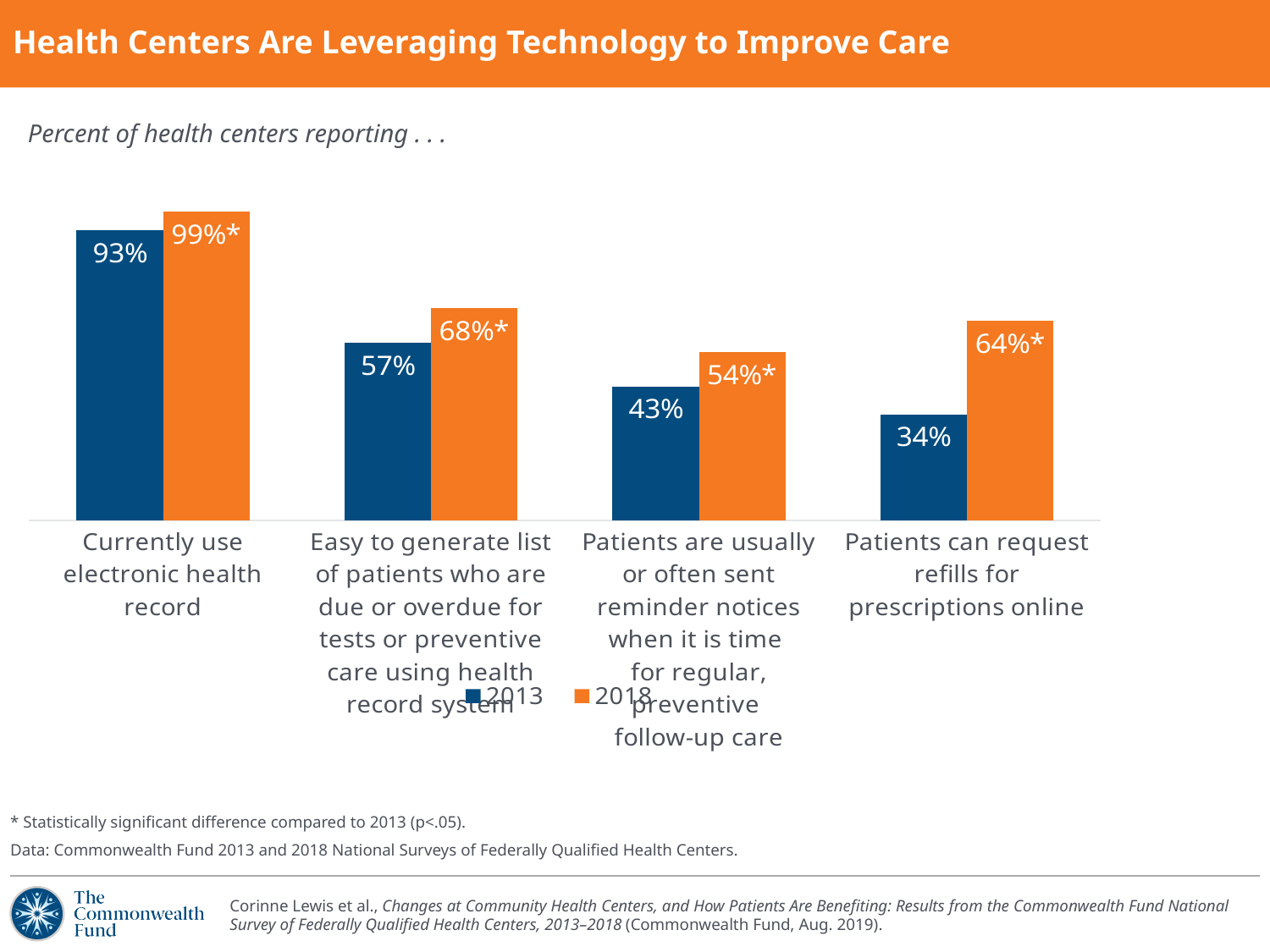
How many series does the chart's legend list? 2 What is the 2013 value for 'Patients are usually or often sent reminder notices when it is time for regular, preventive follow-up care'? 43% By how many percentage points did 'Patients can request refills for prescriptions online' increase from 2013 to 2018? 30 percentage points Which is larger: the 2018 value for 'Patients can request refills for prescriptions online' or the 2018 value for 'Patients are usually or often sent reminder notices'? Patients can request refills for prescriptions online What is the difference between the 2013 and 2018 values for 'Currently use electronic health record'? 6 percentage points What type of chart is shown on the slide? Bar chart How many categories are shown on the x axis of the chart? 4 What is the 2018 value for 'Easy to generate list of patients who are due or overdue for tests or preventive care using health record system'? 68%* What is the 2018 value for 'Patients can request refills for prescriptions online'? 64%* What percentage of health centers reported currently using an electronic health record in 2013? 93% Which category has the lowest 2013 value? Patients can request refills for prescriptions online Which category has the highest 2018 value? Currently use electronic health record